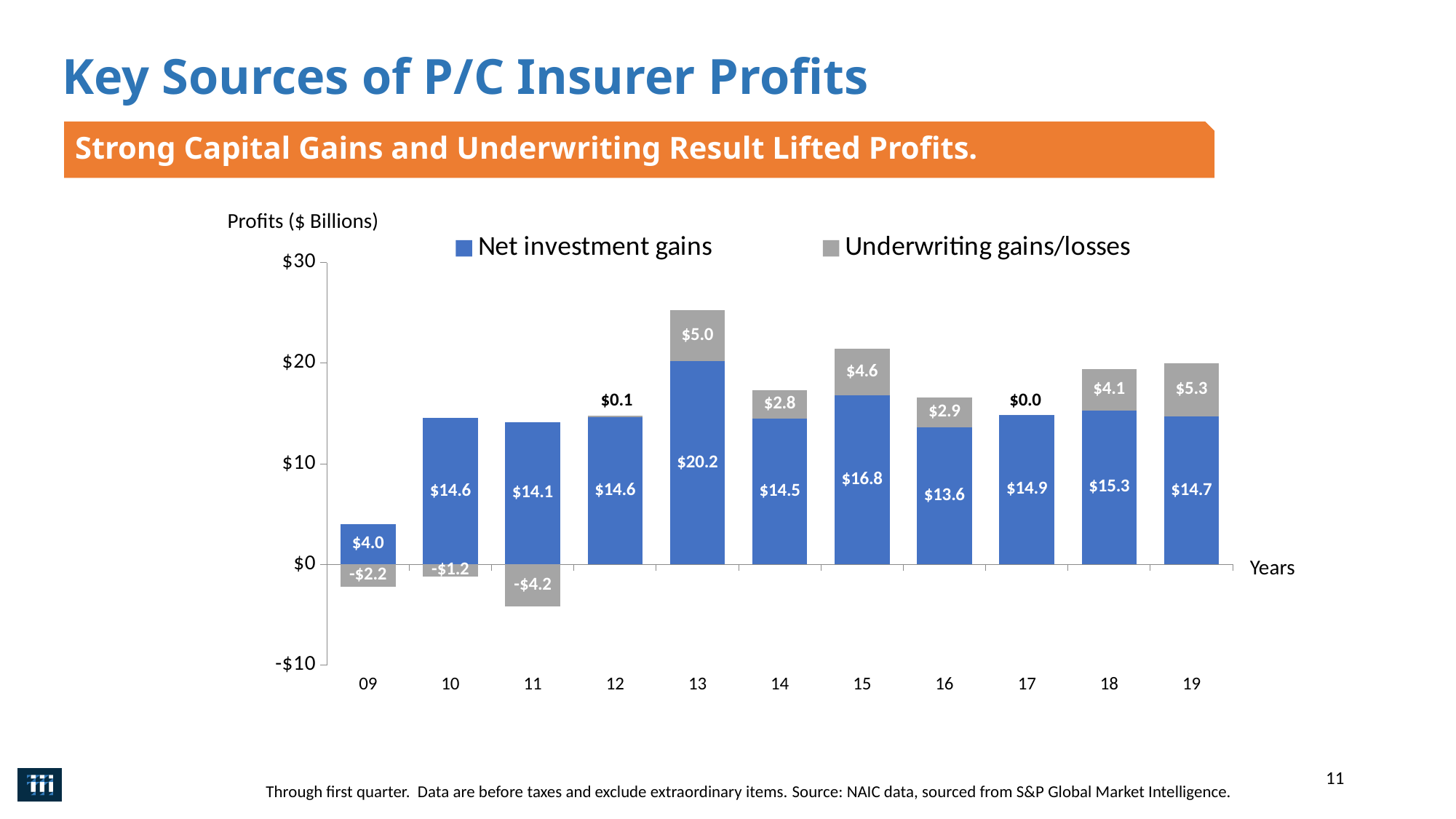
What is the value of Net investment gains for year 13? $20.2 Which year has larger Net investment gains, 15 or 18? 15 How many series does the legend list? 2 What is the value of Underwriting gains/losses for year 19? $5.3 How many years are shown on the x axis? 11 What is the difference between Net investment gains in year 13 and year 09? $16.2 Which year has the lowest Net investment gains? 09 What is the total of the stacked bar for year 15? $21.4 Which year has the highest Net investment gains? 13 Which year has the lowest Underwriting gains/losses value? 11 What is the value of Underwriting gains/losses for year 11? -$4.2 What kind of chart is shown on the slide? Stacked bar chart